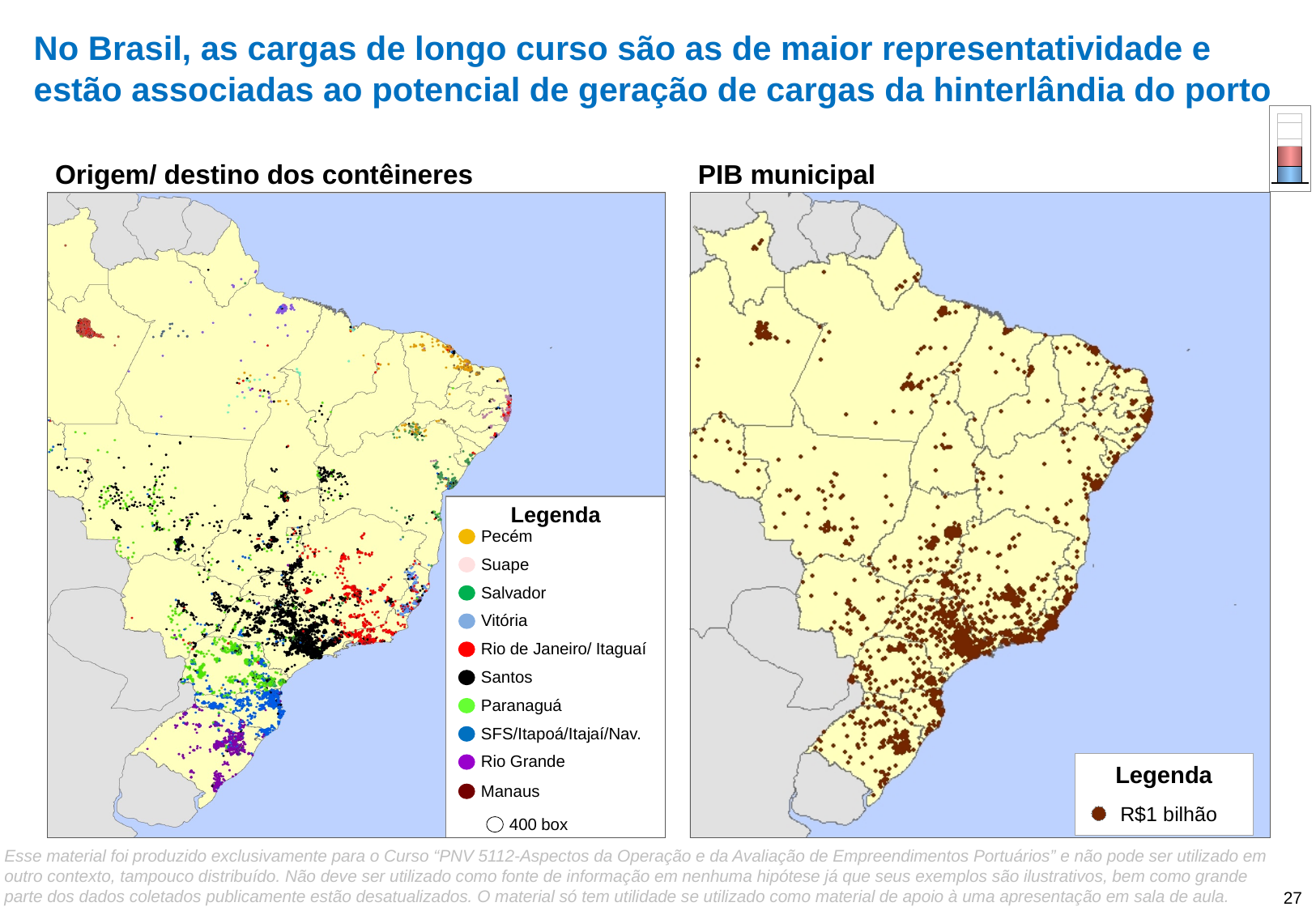
In the right chart 'PIB municipal', what value does one dot in the legend represent? R$1 bilhão In the left chart 'Origem/ destino dos contêineres', what quantity does the circle symbol at the bottom of the legend represent? 400 box In the right chart 'PIB municipal', how many entries does the legend list? 1 What is the title of the right chart on the slide? PIB municipal In the left chart 'Origem/ destino dos contêineres', which colour represents Santos in the legend? Black How many charts (maps) are shown on the slide? 2 In the left chart 'Origem/ destino dos contêineres', how many ports are listed in the legend? 10 What kind of chart is the right chart titled 'PIB municipal'? A map (dot map of Brazil) What kind of chart is the left chart titled 'Origem/ destino dos contêineres'? A map (dot map of Brazil)